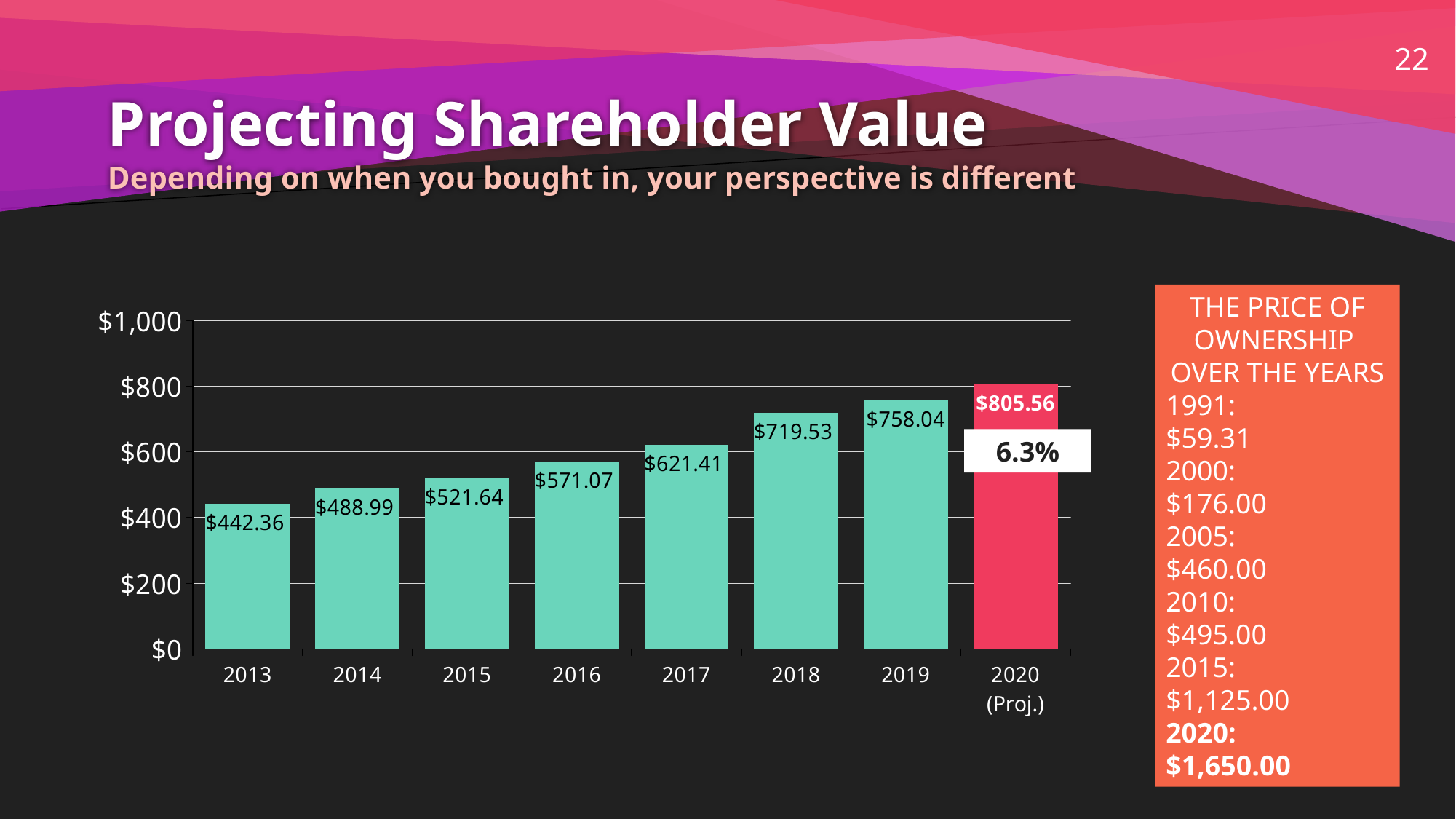
What is the projected value shown for 2020? $805.56 Which is larger, the value for 2015 or the value for 2016? 2016 What kind of chart is shown on the slide? bar chart What is the difference between the 2019 value and the 2018 value? $38.51 Is the value for 2018 greater or less than $600? greater Which year has the lowest bar? 2013 What is the value shown for 2013? $442.36 How many bars are plotted in the chart? 8 Which year has the highest bar? 2020 (Proj.) What is the difference between the 2020 (Proj.) value and the 2019 value? $47.52 What is the value shown for 2017? $621.41 Do the values rise or fall from 2013 to 2020? rise